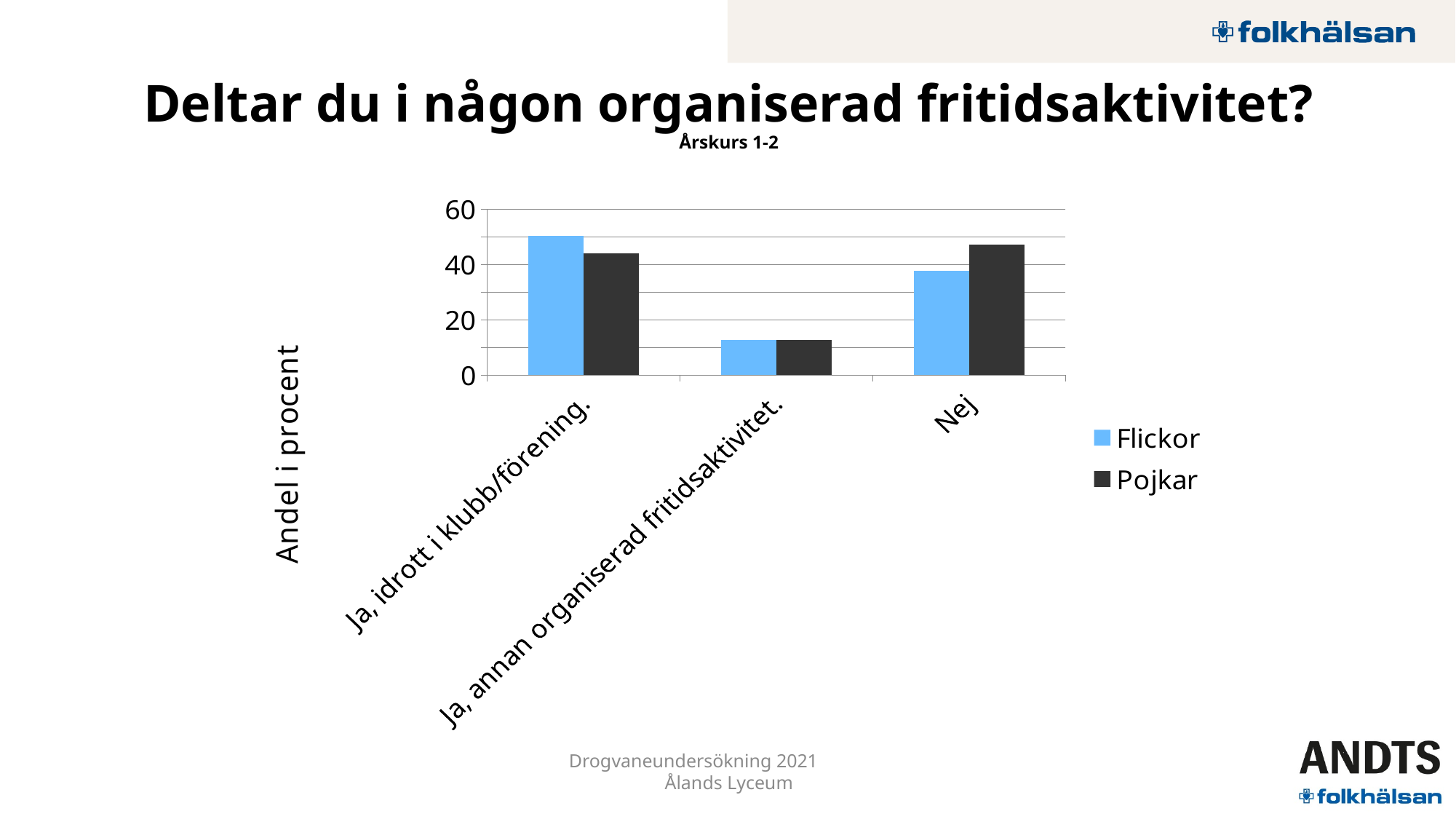
Is the Pojkar value for "Ja, annan organiserad fritidsaktivitet." greater or less than 20? less Which category has the highest Flickor value? Ja, idrott i klubb/förening. How many categories are shown on the x axis of the chart? 3 Is the Pojkar value for "Nej" greater or less than 40? greater For "Nej", which series has the larger value, Flickor or Pojkar? Pojkar For "Ja, idrott i klubb/förening.", which series has the larger value, Flickor or Pojkar? Flickor What kind of chart is shown on the slide? bar chart What is the label on the vertical axis of the chart? Andel i procent Is the Flickor value for "Nej" greater or less than 40? less Which category has the lowest Flickor value? Ja, annan organiserad fritidsaktivitet. How many series does the legend list? 2